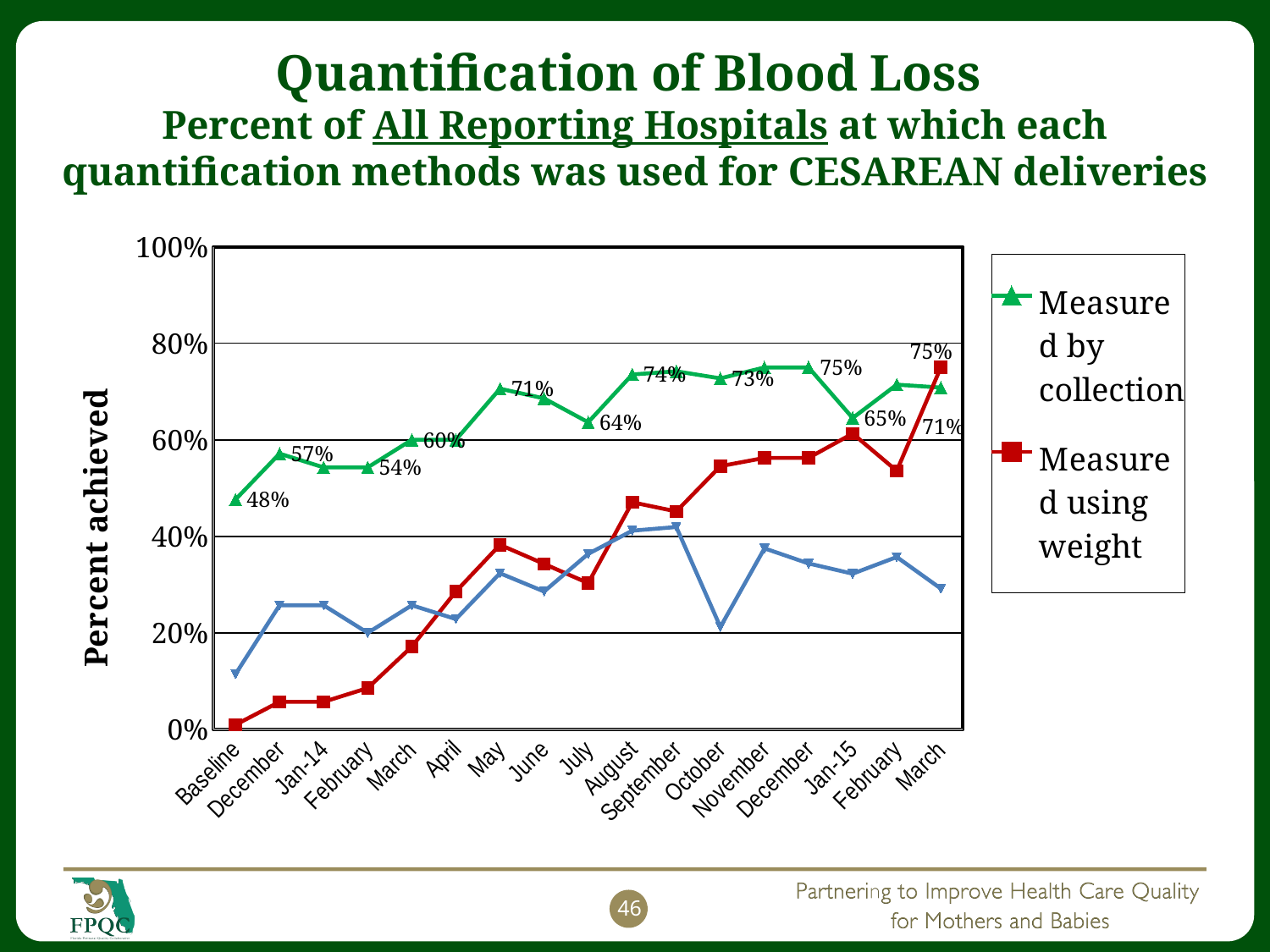
What kind of chart is shown on the slide? line chart What is the value for 'Measured by collection' in May? 71% What is the value for 'Measured using weight' at the final March point? 75% What is the difference between the 'Measured by collection' values in May and at Baseline? 23 percentage points At Baseline, which series has the larger value: 'Measured by collection' or 'Measured using weight'? Measured by collection How many time points are plotted along the x axis? 17 What is the value for 'Measured by collection' at Baseline? 48% What is the value for 'Measured by collection' in July? 64% What is the value for 'Measured by collection' at Jan-15? 65% Does the 'Measured using weight' series generally rise or fall from Baseline to the final March? rise How many series does the legend list? 2 Is the value for 'Measured using weight' at Baseline greater or less than 20%? less